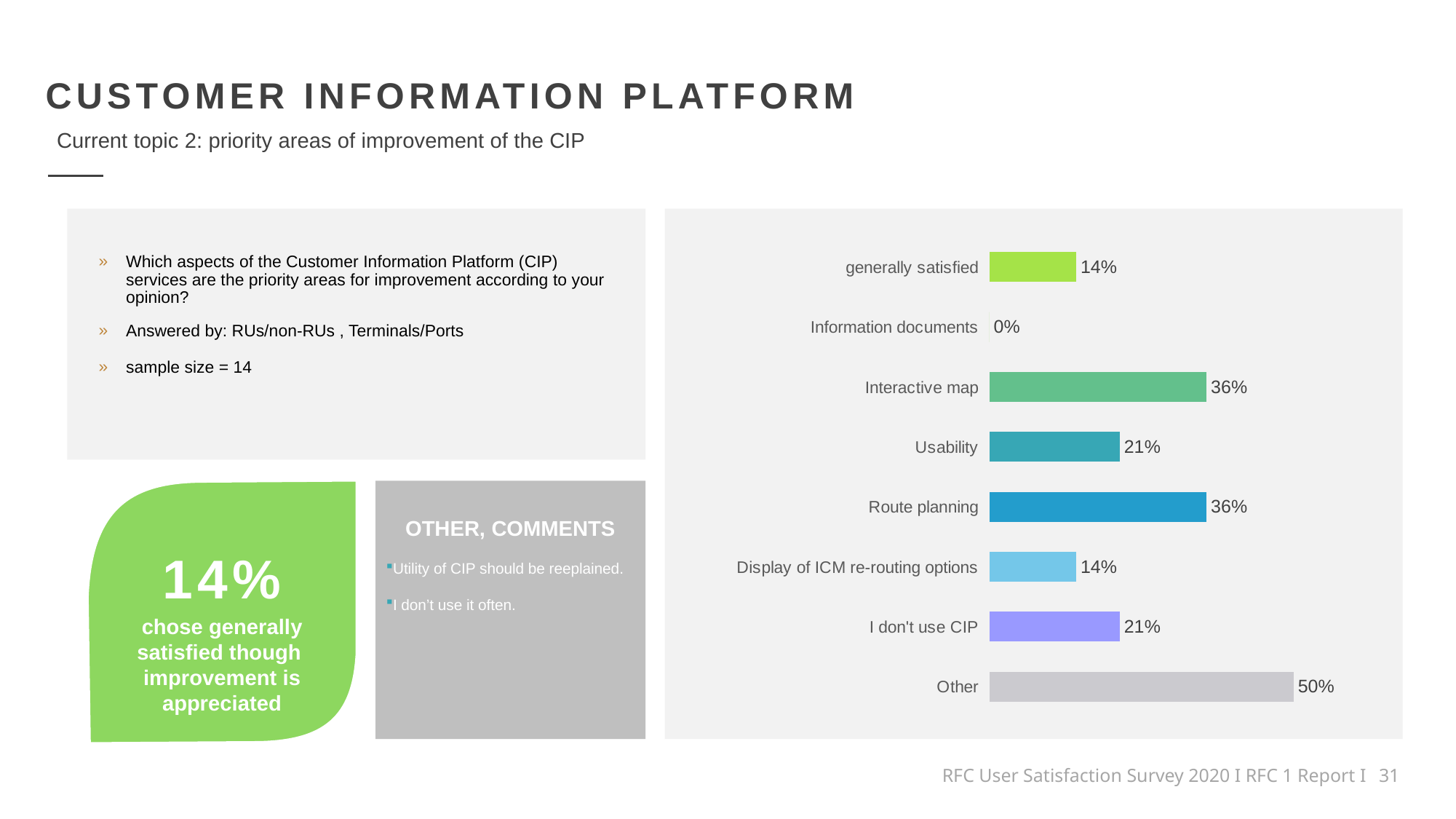
What is the difference between the values for Usability and generally satisfied? 7% Which category has the highest value? Other What colour is the bar for Other? grey What is the value for Information documents? 0% What is the value for Display of ICM re-routing options? 14% How many categories are shown in the chart? 8 Which category has the lowest value? Information documents What kind of chart is shown on the slide? bar chart What is the value for Usability? 21% What is the value for Interactive map? 36% What is the difference between the values for Other and Route planning? 14% Which is larger, the value for I don't use CIP or the value for generally satisfied? I don't use CIP